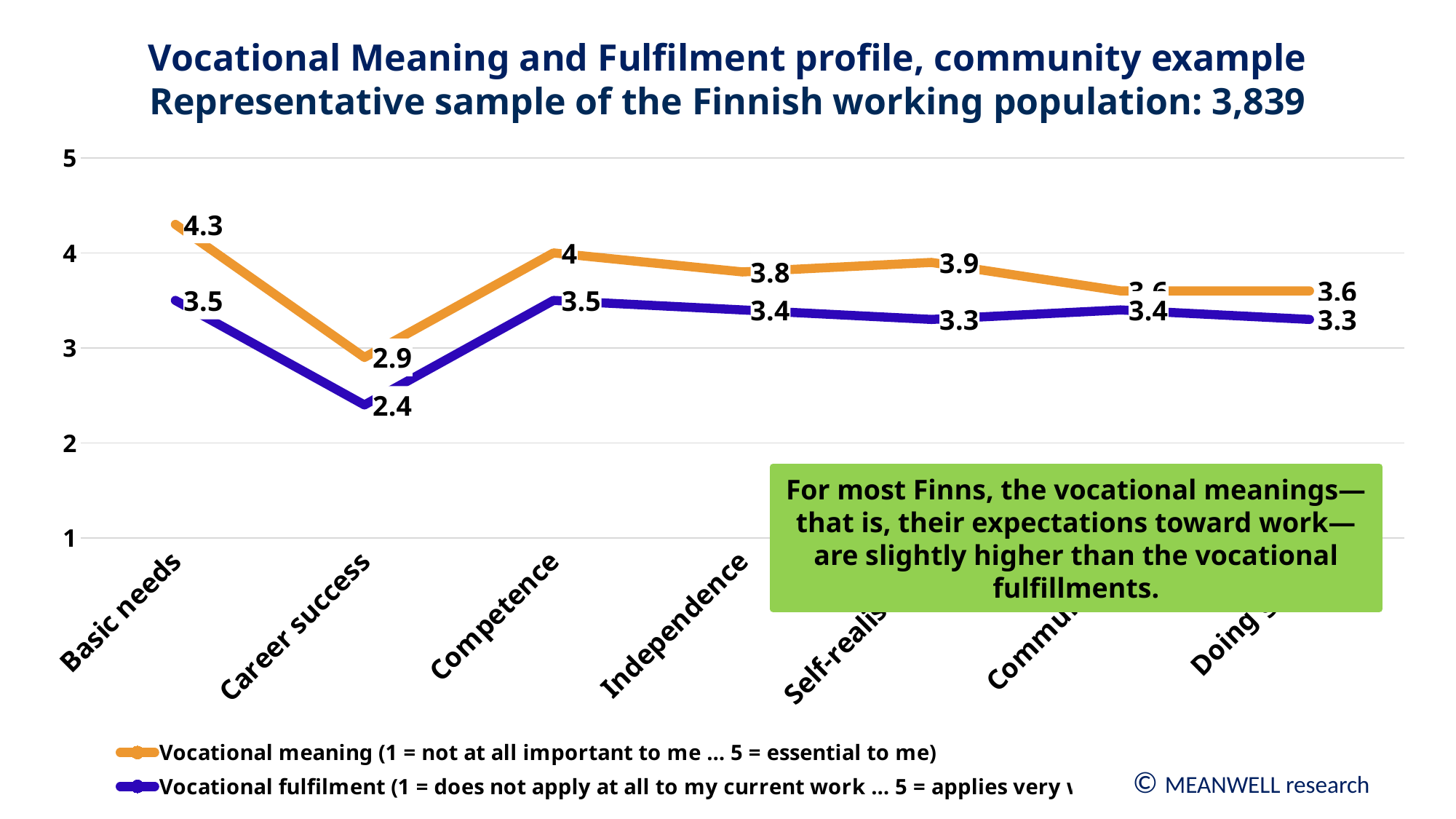
Which category has the lowest Vocational fulfilment value? Career success What is the Vocational fulfilment value for Career success? 2.4 How many series does the legend list? 2 How many categories are plotted along the x axis? 7 What is the difference between the Vocational meaning and Vocational fulfilment values for Basic needs? 0.8 What is the Vocational fulfilment value for Independence? 3.4 Is the Vocational meaning value for Career success greater or less than 3? less Which category has the highest Vocational meaning value? Basic needs What is the Vocational meaning value for Competence? 4 For Competence, which series has the larger value, Vocational meaning or Vocational fulfilment? Vocational meaning What kind of chart is shown on the slide? line chart What is the Vocational meaning value for Basic needs? 4.3